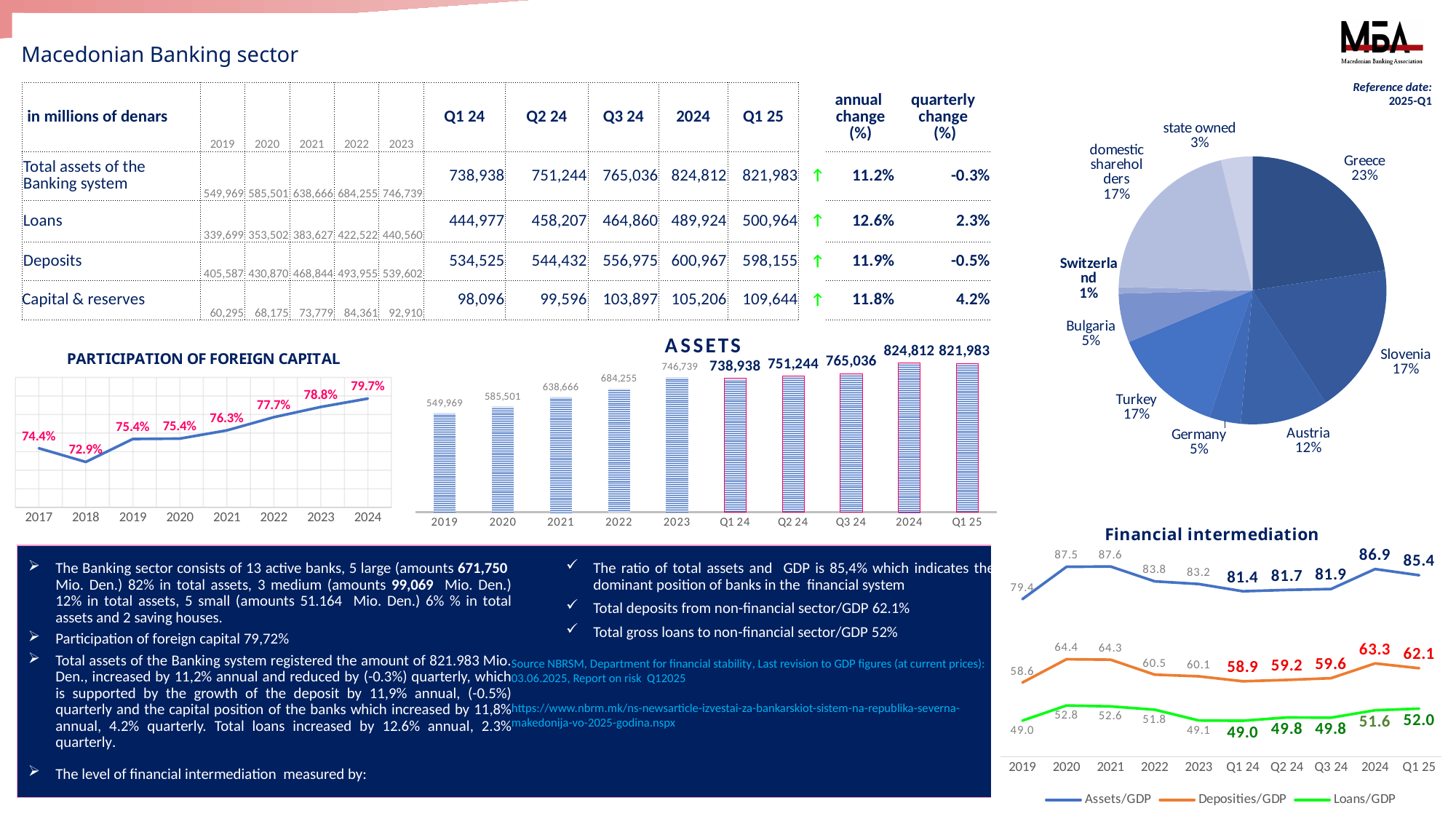
In the Financial intermediation chart, what is the Assets/GDP value for Q1 25? 85.4 In the ASSETS chart, which period has the highest value? 2024 In the PARTICIPATION OF FOREIGN CAPITAL chart, which year has the lowest value? 2018 What kind of chart is the ASSETS chart? Bar chart In the PARTICIPATION OF FOREIGN CAPITAL chart, how many years are plotted? 8 In the ASSETS chart, what is the value for Q3 24? 765,036 In the pie chart, what share does Greece have? 23% How many series does the legend of the Financial intermediation chart list? 3 In the PARTICIPATION OF FOREIGN CAPITAL chart, what is the value for 2024? 79.7% In the Financial intermediation chart, is the Deposities/GDP value for 2024 larger or smaller than the Loans/GDP value for 2024? Larger In the pie chart, which country has the smallest share? Switzerland In the ASSETS chart, what is the difference between the 2024 and Q1 25 values? 2,829